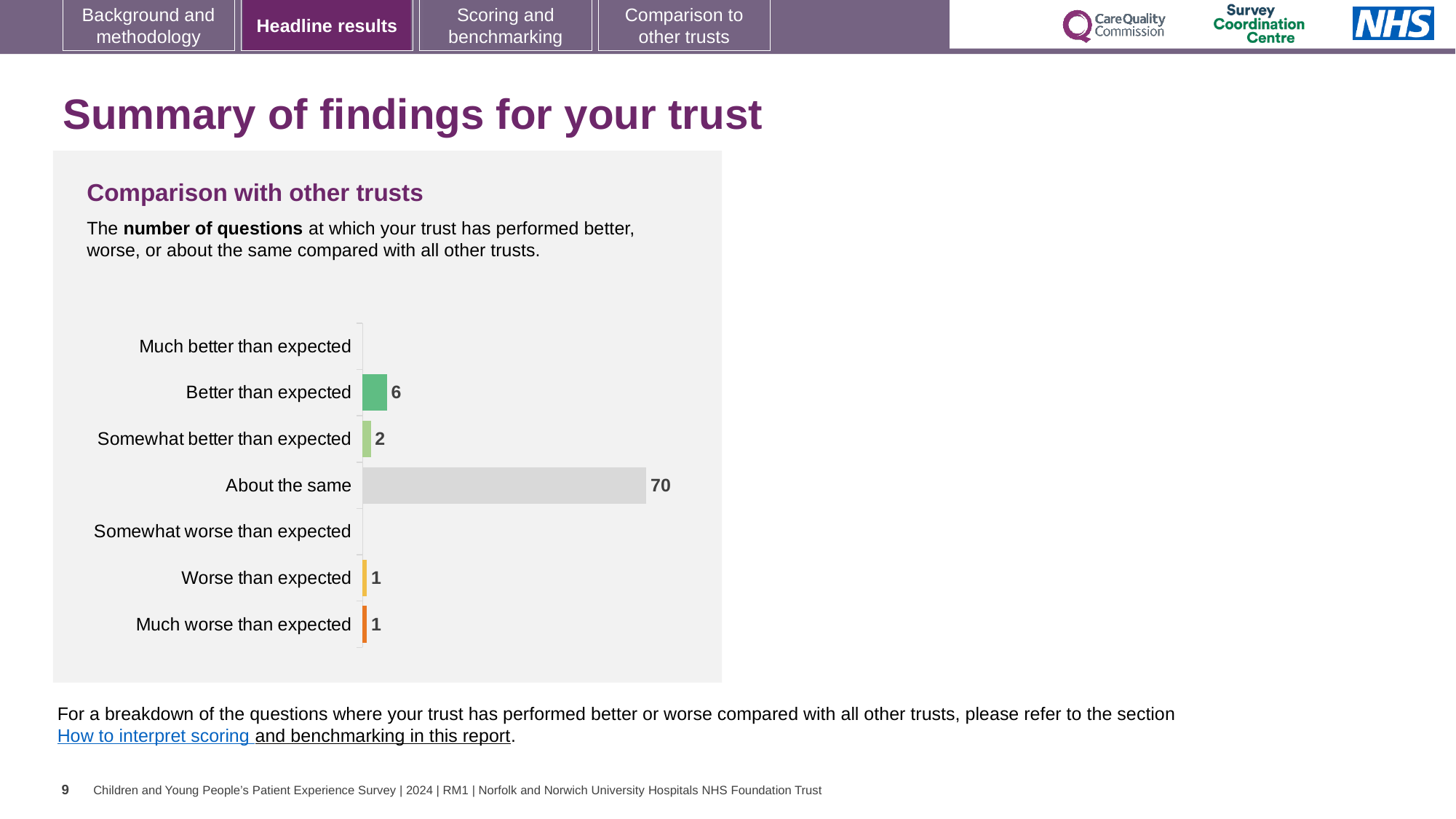
How many questions were rated 'Worse than expected'? 1 How many questions were rated 'Somewhat better than expected'? 2 What is the title of the chart section? Comparison with other trusts Which is larger: 'Better than expected' or 'Somewhat better than expected'? Better than expected What kind of chart is shown on the slide? Bar chart How many questions were rated 'About the same'? 70 How many categories are listed on the chart's vertical axis? 7 What is the difference between the number of questions rated 'About the same' and 'Better than expected'? 64 Which category has the highest number of questions? About the same What is the difference between 'Better than expected' and 'Somewhat better than expected'? 4 How many questions were rated 'Better than expected'? 6 How many questions were rated 'Much worse than expected'? 1